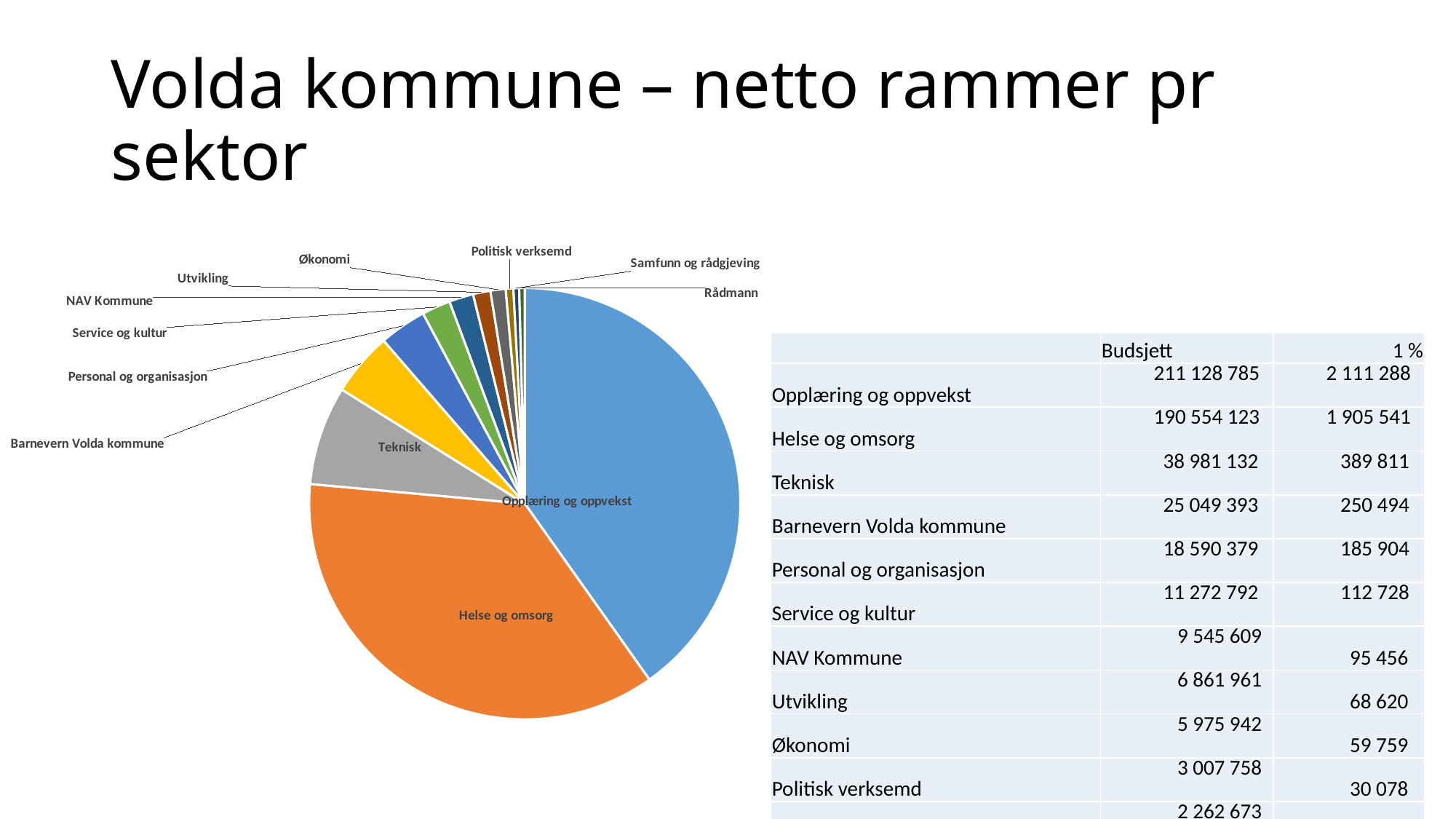
Using the Budsjett values in the table, what is the difference between Opplæring og oppvekst and Helse og omsorg? 20 574 662 What colour is the Helse og omsorg slice in the pie chart? orange According to the table on the slide, what is the Budsjett value for NAV Kommune? 9 545 609 Which sector has the largest slice in the pie chart? Opplæring og oppvekst According to the table on the slide, what is the Budsjett value for Teknisk? 38 981 132 Which slice is larger, Opplæring og oppvekst or Helse og omsorg? Opplæring og oppvekst How many slices does the pie chart have? 12 According to the table on the slide, what is the Budsjett value for Helse og omsorg? 190 554 123 Which slice is larger, Teknisk or Barnevern Volda kommune? Teknisk What is the title of the slide containing the pie chart? Volda kommune – netto rammer pr sektor Which slice is larger, Helse og omsorg or Teknisk? Helse og omsorg What kind of chart is shown on the slide? pie chart